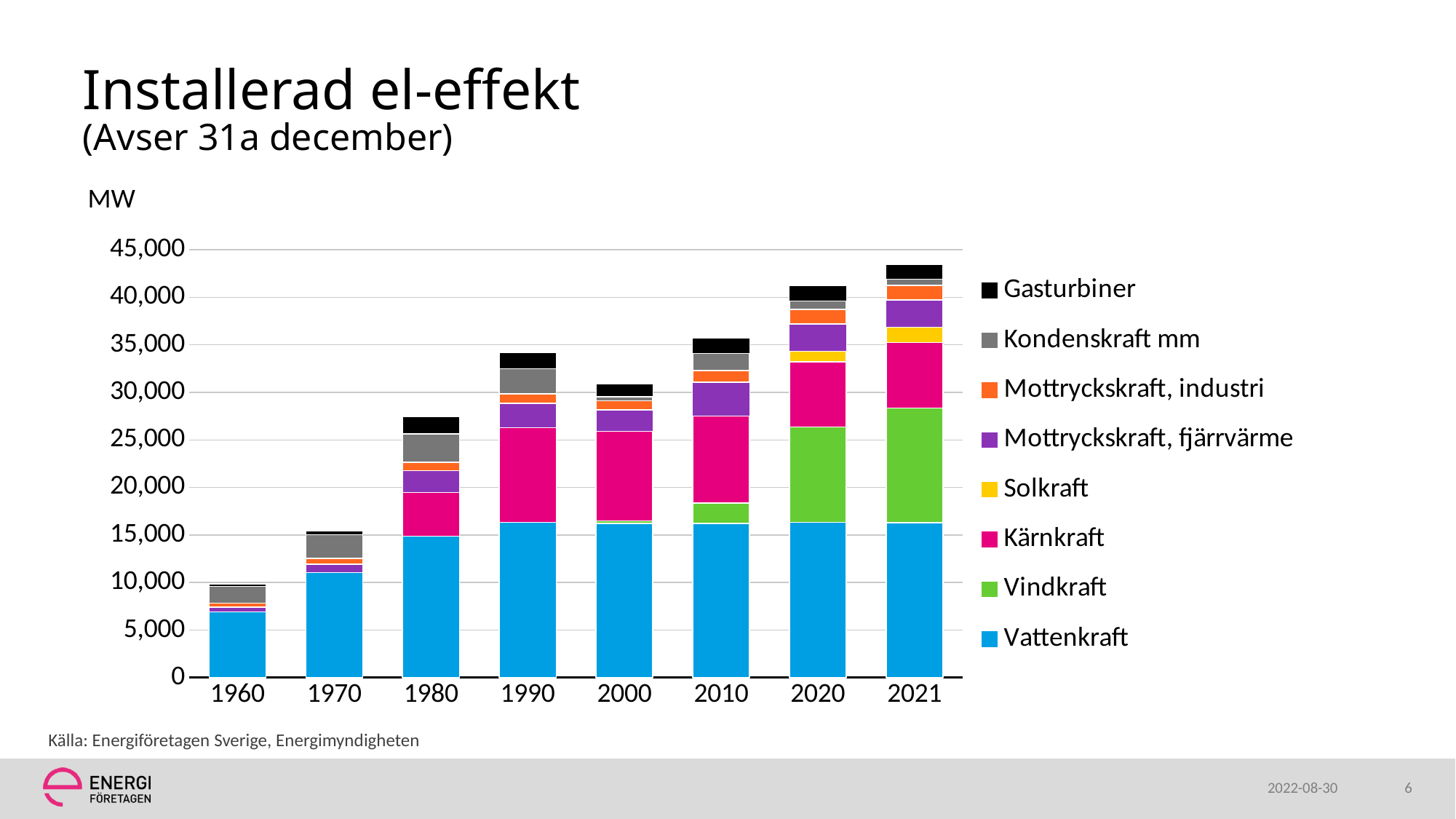
What kind of chart is shown on the slide? Stacked bar chart Which year has the larger total installed capacity, 1990 or 2000? 1990 Is the total for 2021 greater or less than 40,000 MW? greater Is the total for 1990 greater or less than 35,000 MW? less Which year has the highest total installed capacity? 2021 Which colour represents Vattenkraft in the legend? Blue What unit is shown on the y axis of the chart? MW How many series does the legend list? 8 Is the total for 1980 greater or less than 25,000 MW? greater Which year has the lowest total installed capacity? 1960 How many years are shown along the x axis of the chart? 8 In 2021, which segment is larger, Vindkraft or Kärnkraft? Vindkraft